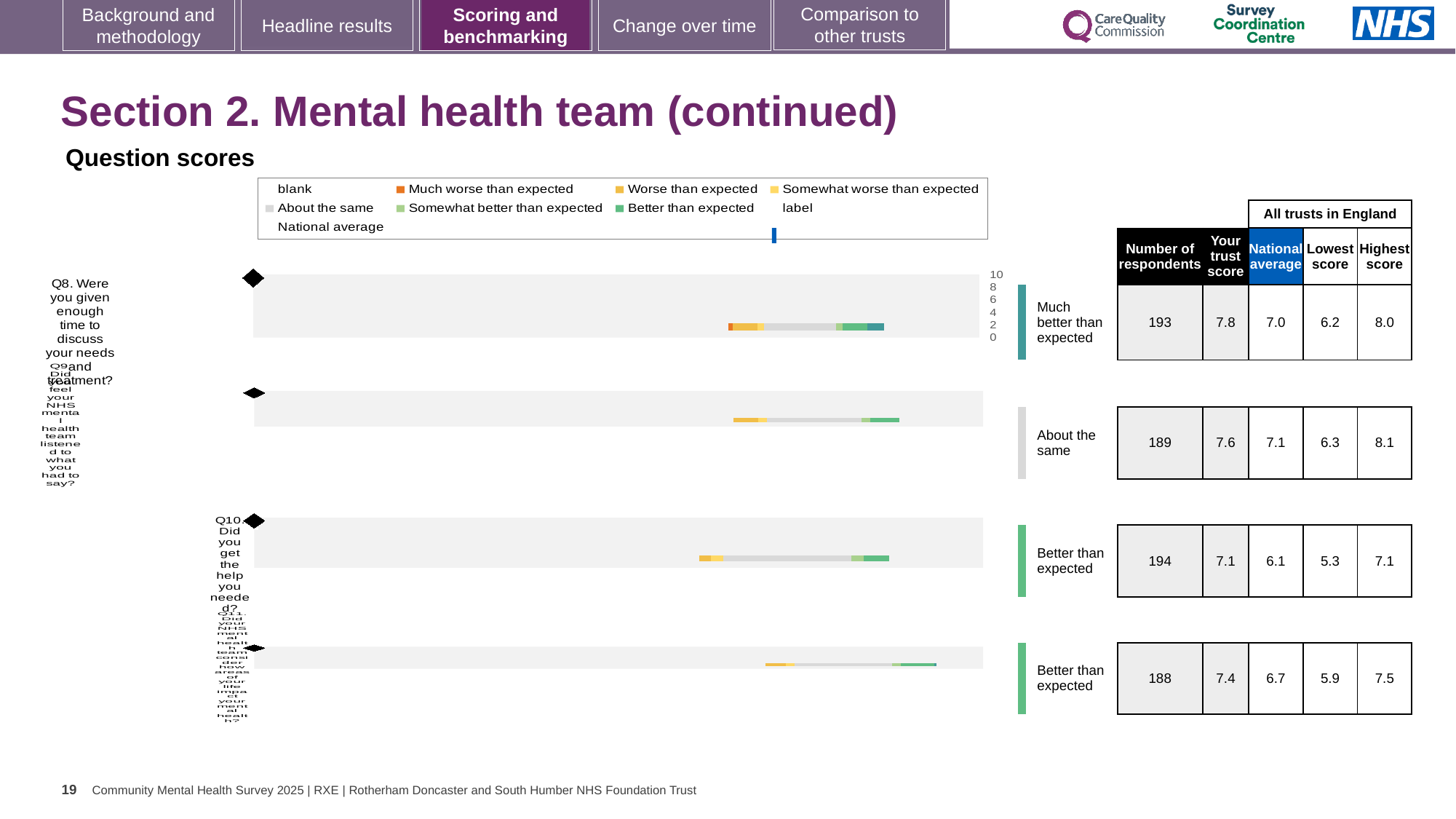
How many respondents answered Q9? 189 Which question has the lowest 'Your trust score' on this slide? Q10 What is the 'Your trust score' for Q8 (Were you given enough time to discuss your needs and treatment?)? 7.8 What type of chart is used to show the question scores on this slide? bar chart What is the difference between the trust score and the national average for Q8? 0.8 What is the highest score across all trusts in England for Q11? 7.5 How many questions (Q8 to Q11) are plotted as bars on this slide? 4 In the chart legend, what colour represents 'Much worse than expected'? orange Which question has the highest 'Your trust score' on this slide? Q8 What benchmark category is shown for Q9 (Did you feel your NHS mental health team listened to what you had to say?)? About the same What is the national average score for Q10 (Did you get the help you needed?)? 6.1 For Q10, which is larger: the trust score or the national average? the trust score